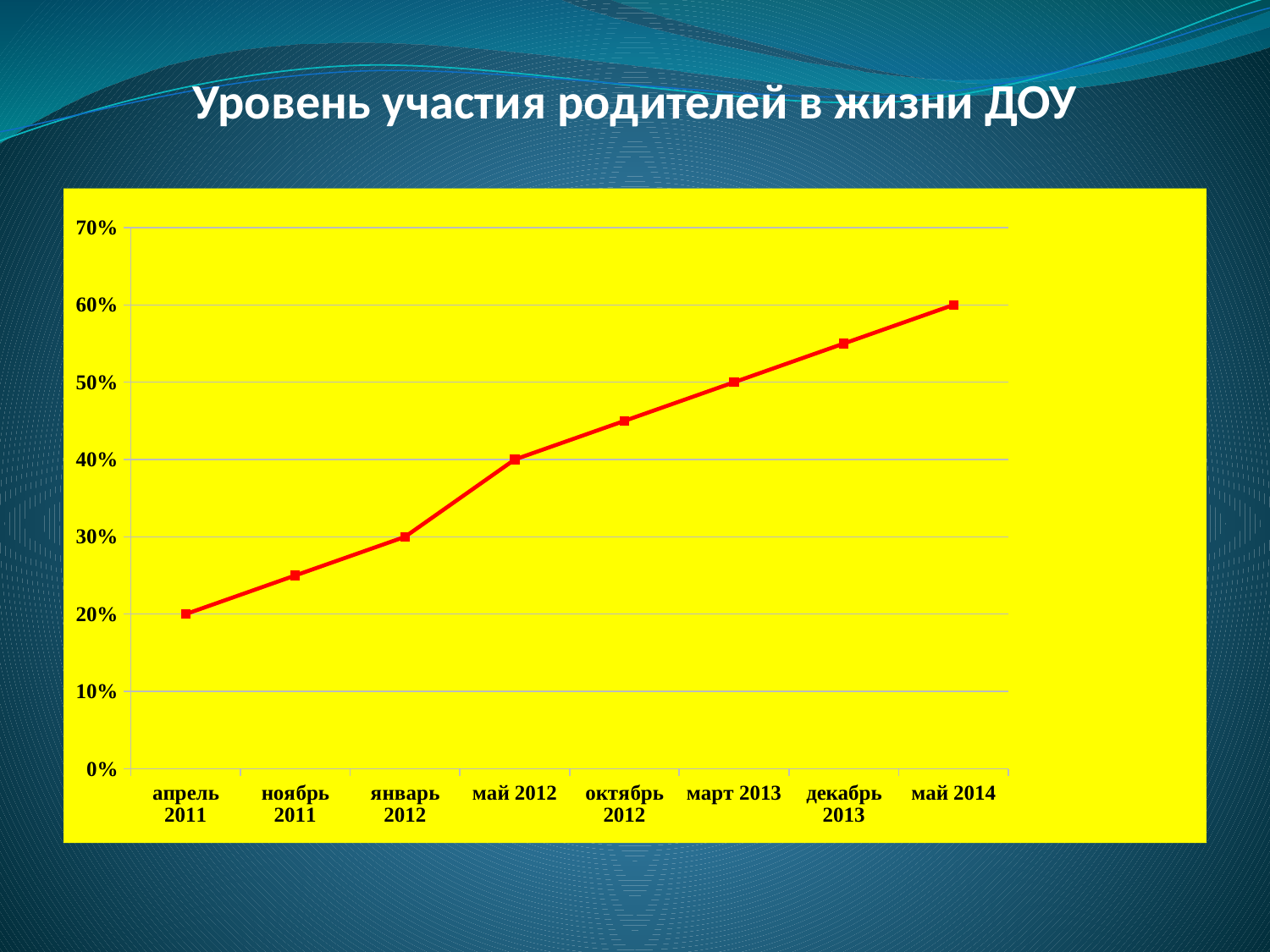
Which point on the x axis has the lowest value? апрель 2011 What is the value for май 2014? 60% How many data points are plotted on the line? 8 What is the difference between the values for май 2014 and апрель 2011? 40% Is the value for октябрь 2012 greater or less than 40%? greater What is the value for март 2013? 50% What is the value for апрель 2011? 20% What is the value for май 2012? 40% Is the value for ноябрь 2011 greater or less than 30%? less Do the values rise or fall from апрель 2011 to май 2014? rise Which point on the x axis has the highest value? май 2014 What type of chart is shown on the slide? line chart